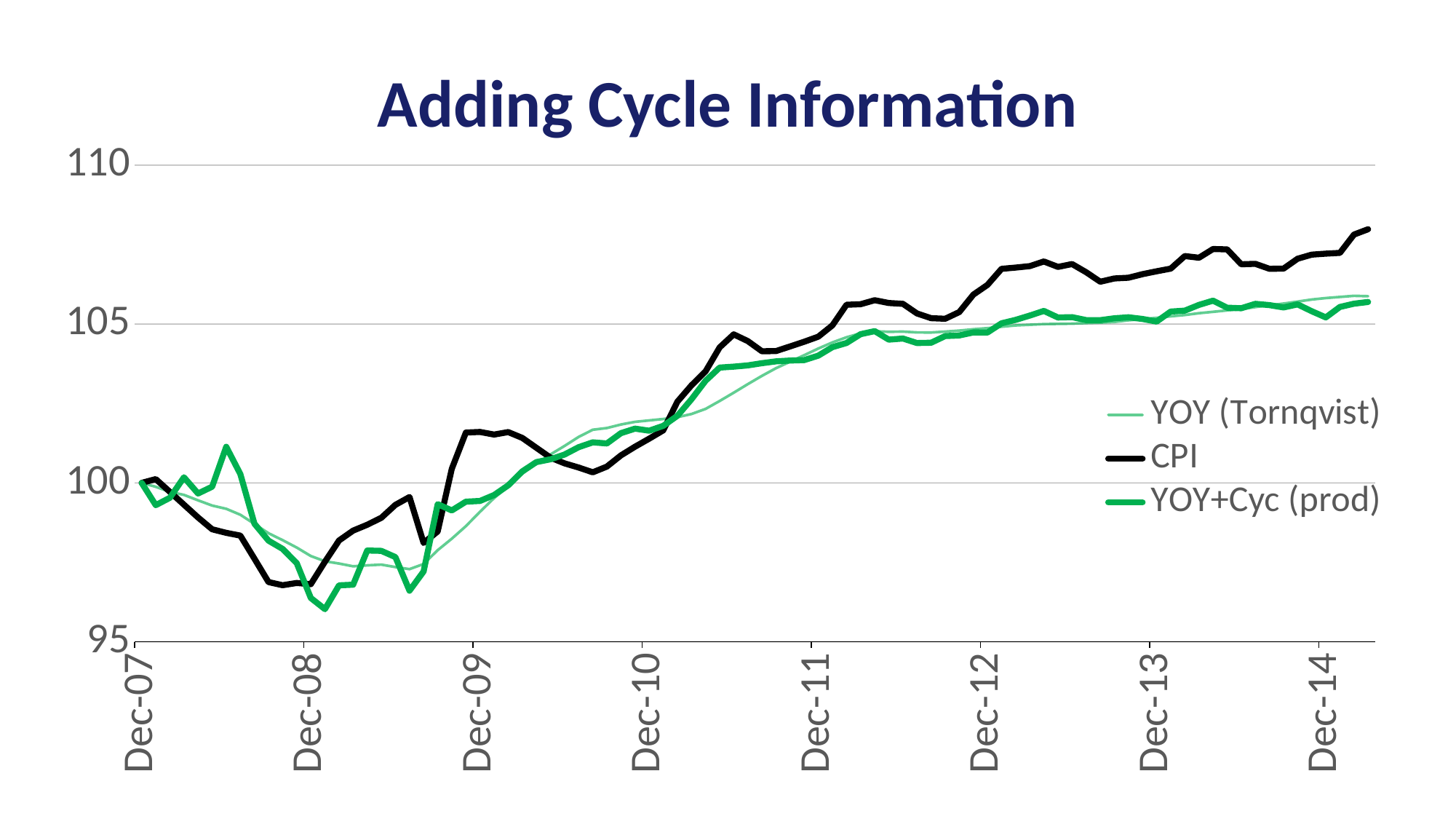
At Dec-14, which is higher: CPI or YOY+Cyc (prod)? CPI Does the CPI series rise or fall between Dec-07 and Dec-08? fall How many date labels are shown on the x axis? 8 What kind of chart is shown on the slide? line chart Is the value of CPI at Dec-12 greater or less than 105? greater Is the value of YOY+Cyc (prod) at Dec-08 greater or less than 100? less What is the title of the chart? Adding Cycle Information How many series does the legend list? 3 Which series is drawn with a black line? CPI Is the value of CPI at Dec-08 greater or less than 100? less Which series reaches the lowest value anywhere on the chart? YOY+Cyc (prod)